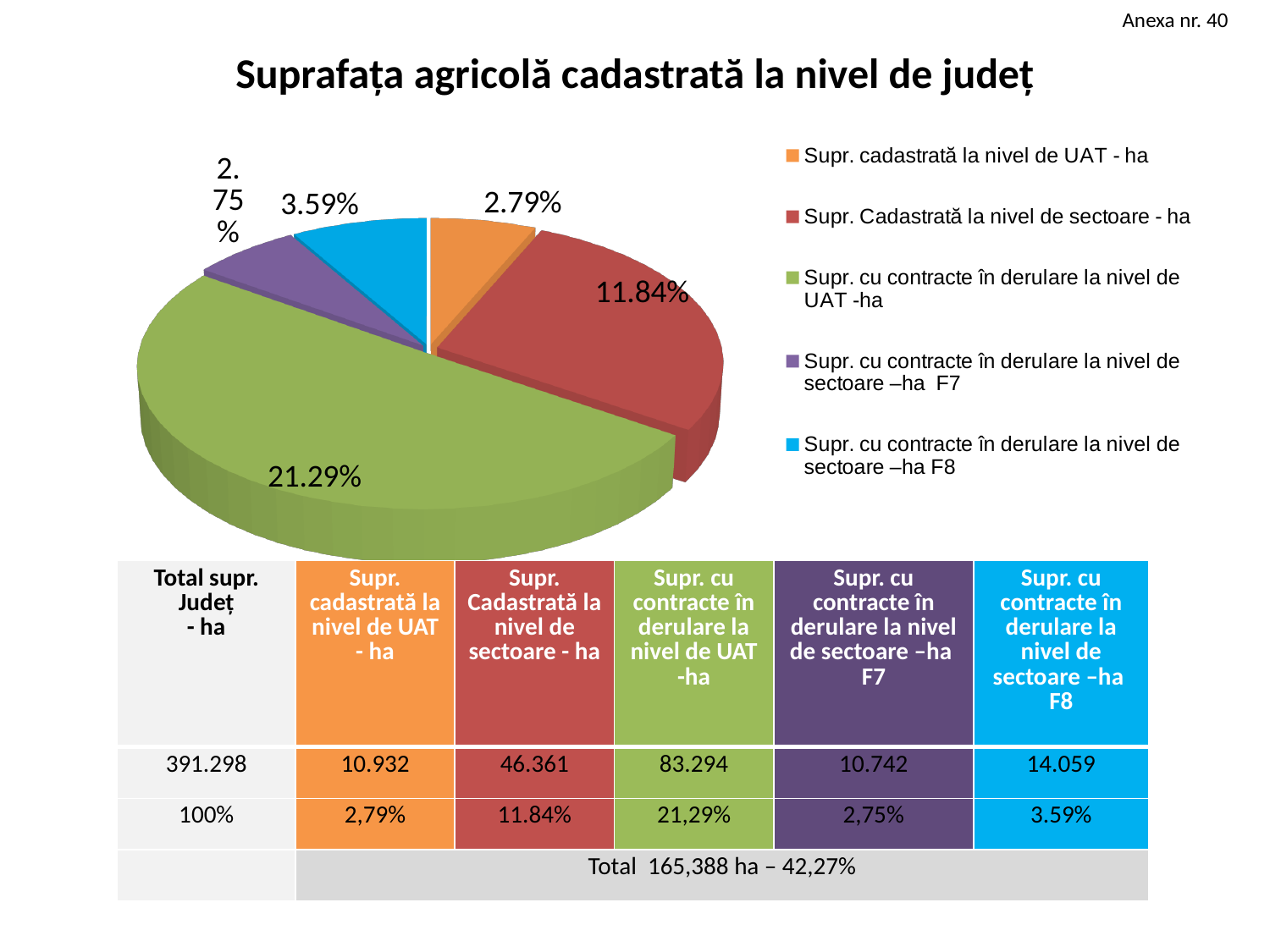
What type of chart is shown on the slide? pie chart How many entries does the chart legend list? 5 What percentage is shown for the slice 'Supr. Cadastrată la nivel de sectoare - ha'? 11.84% What is the difference between the percentage for 'Supr. cu contracte în derulare la nivel de UAT -ha' and the percentage for 'Supr. Cadastrată la nivel de sectoare - ha'? 9.45% What percentage is shown for the slice 'Supr. cu contracte în derulare la nivel de sectoare –ha F8'? 3.59% How many slices does the pie chart have? 5 Which is larger: the slice for 'Supr. Cadastrată la nivel de sectoare - ha' or the slice for 'Supr. cu contracte în derulare la nivel de sectoare –ha F8'? Supr. Cadastrată la nivel de sectoare - ha What is the title of the chart on the slide? Suprafața agricolă cadastrată la nivel de județ Which slice of the pie chart is the largest? Supr. cu contracte în derulare la nivel de UAT -ha What percentage is shown for the slice 'Supr. cu contracte în derulare la nivel de UAT -ha'? 21.29% What colour is the slice for 'Supr. cu contracte în derulare la nivel de UAT -ha'? green What percentage is shown for the slice 'Supr. cadastrată la nivel de UAT - ha'? 2.79%